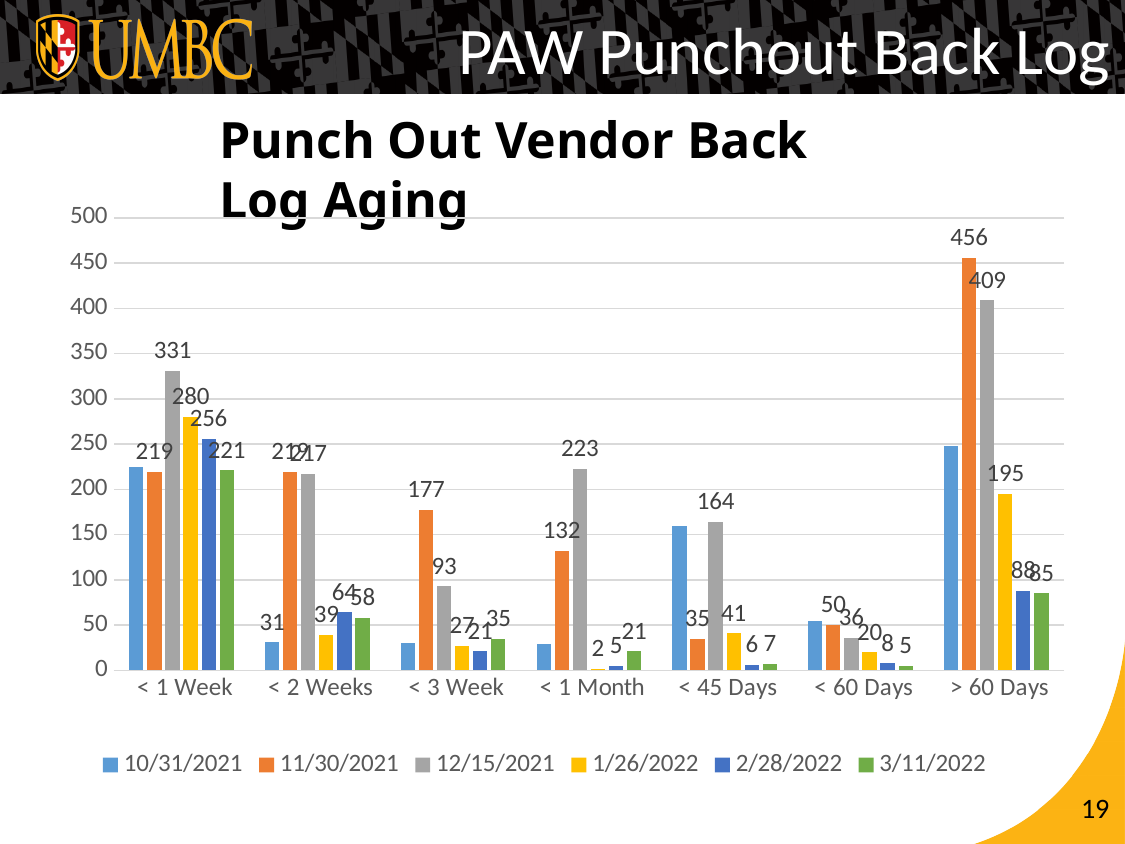
What is the value for 11/30/2021 in the < 3 Week category? 177 In the < 1 Month category, which is larger: the value for 12/15/2021 or for 11/30/2021? 12/15/2021 What is the difference between the 11/30/2021 and 12/15/2021 values in the > 60 Days category? 47 How many aging categories are shown on the x axis? 7 How many series does the legend list? 6 What is the value for 11/30/2021 in the > 60 Days category? 456 Which series has the lowest value in the < 1 Month category? 1/26/2022 Is the value for 10/31/2021 in the > 60 Days category greater or less than 200? greater What kind of chart is shown on the slide? bar chart What is the value for 1/26/2022 in the > 60 Days category? 195 What is the value for 12/15/2021 in the < 1 Week category? 331 Which series has the highest value in the > 60 Days category? 11/30/2021